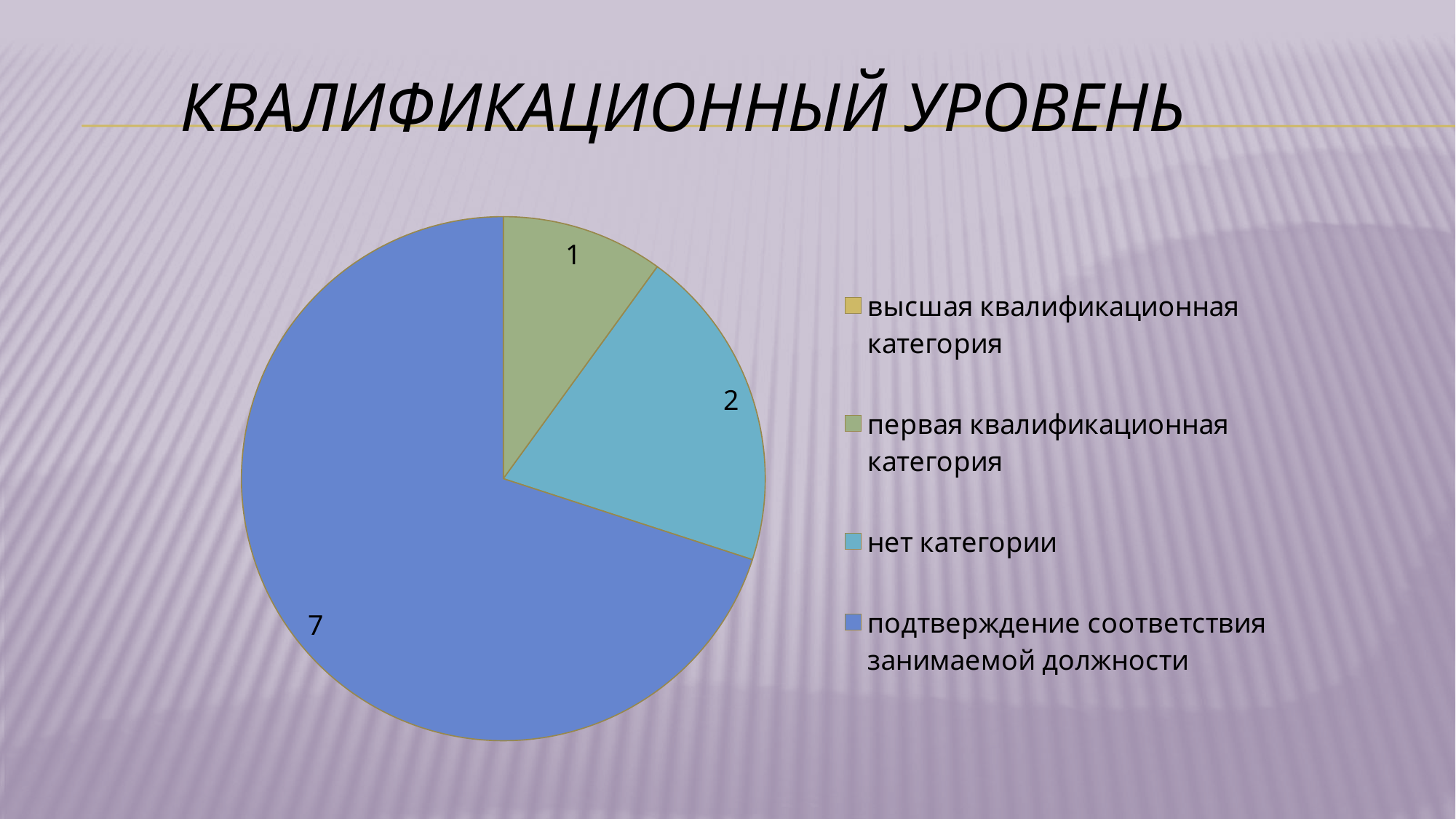
What is the value for 'подтверждение соответствия занимаемой должности'? 7 What colour is the slice for 'подтверждение соответствия занимаемой должности'? blue How many entries does the chart's legend list? 4 What type of chart is shown on the slide? pie chart What is the value for 'первая квалификационная категория'? 1 Which is larger: the value for 'нет категории' or for 'первая квалификационная категория'? нет категории How many slices with data labels are visible in the pie chart? 3 What is the value for 'нет категории'? 2 Which of the labeled slices is the smallest? первая квалификационная категория What is the difference between the values for 'подтверждение соответствия занимаемой должности' and 'нет категории'? 5 What is the title of the chart on the slide? Квалификационный уровень Which category has the largest slice in the pie chart? подтверждение соответствия занимаемой должности